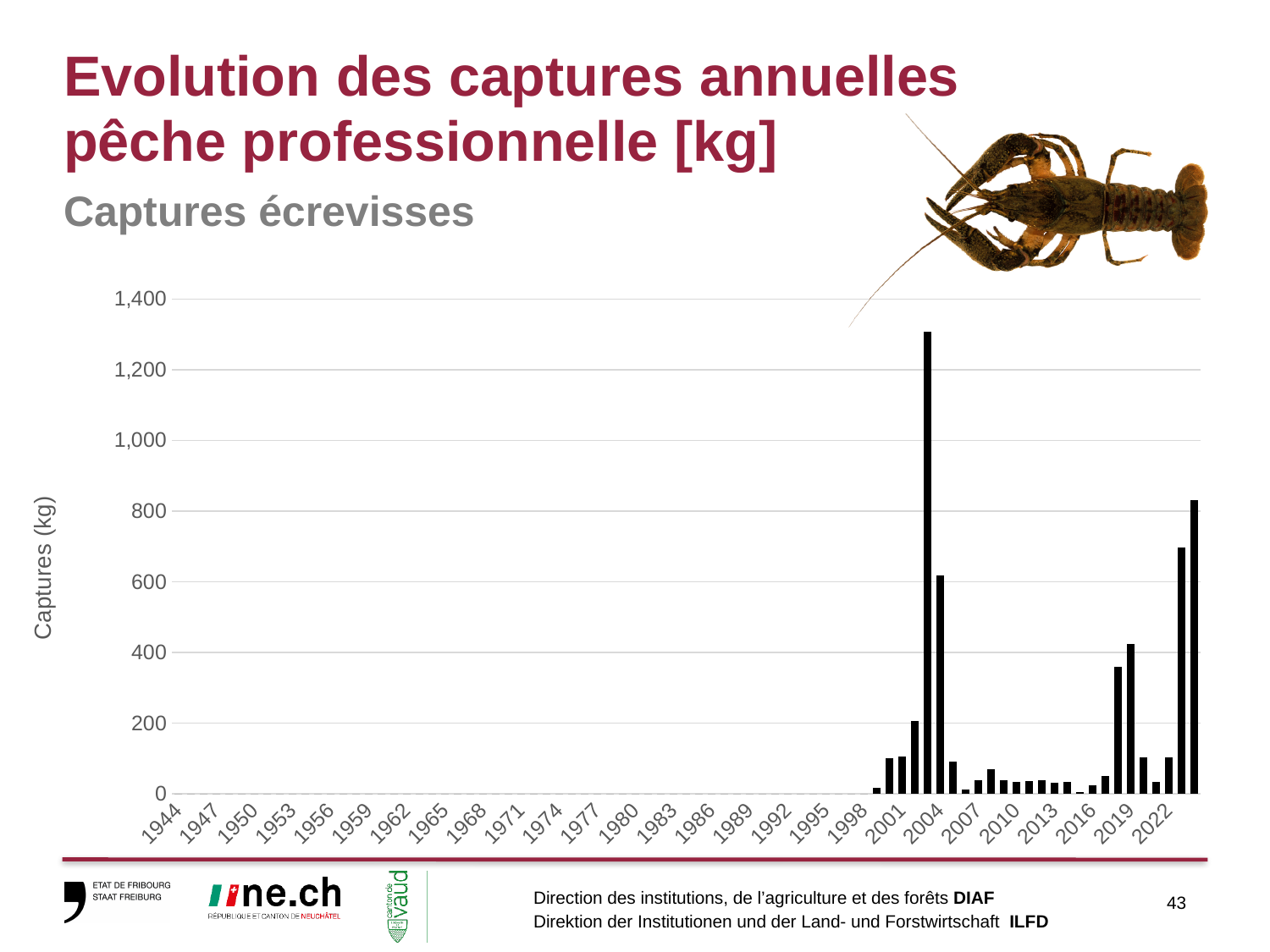
Is the value of the rightmost (most recent) bar greater or less than 600? greater How many year labels are shown on the x axis? 27 Is the value of the bar at 2019 greater or less than 200? greater What is the highest tick value shown on the y axis? 1,400 What is the label on the vertical axis of the chart? Captures (kg) Is the value of the tallest bar greater or less than 1,200? greater What is the first year label on the x axis? 1944 What is the title shown above the chart? Captures écrevisses What type of chart is shown on the slide? bar chart Are there any visible catches in the years before 1998? no Does the tallest bar occur in the early 2000s or in the 2020s? early 2000s